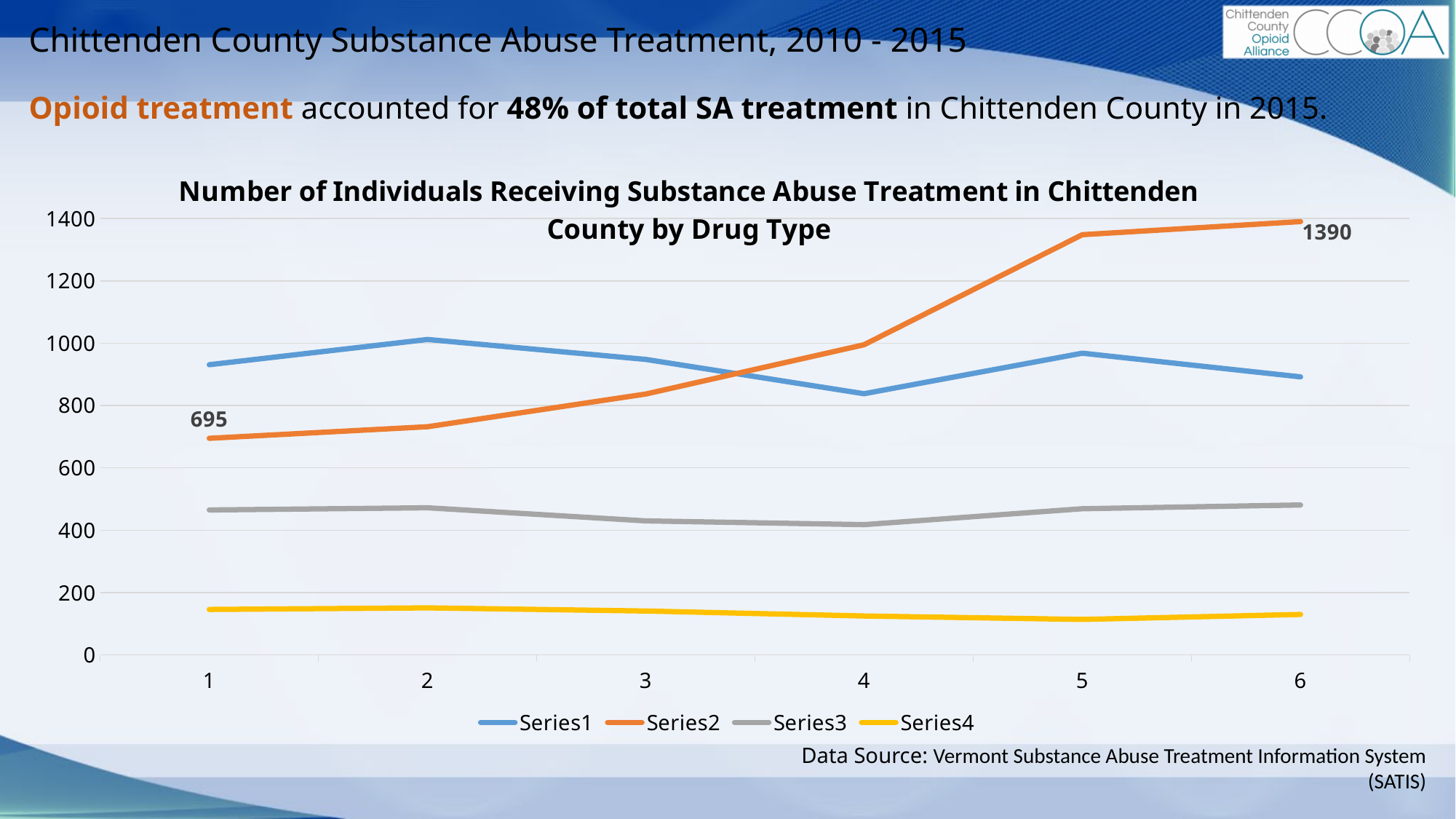
What is the value of Series2 at x = 1? 695 Which series has the highest value at x = 6? Series2 At x = 1, which is larger: Series1 or Series2? Series1 What is the value of Series2 at x = 6? 1390 Does Series2 rise or fall from x = 1 to x = 6? rise How many series does the legend list? 4 Which series has the lowest value at x = 1? Series4 Is the value for Series1 at x = 1 greater or less than 800? greater What is the title of the chart? Number of Individuals Receiving Substance Abuse Treatment in Chittenden County by Drug Type What is the difference between the Series2 value at x = 6 and at x = 1? 695 How many points are plotted along the x axis for each series? 6 What type of chart is shown on the slide? line chart